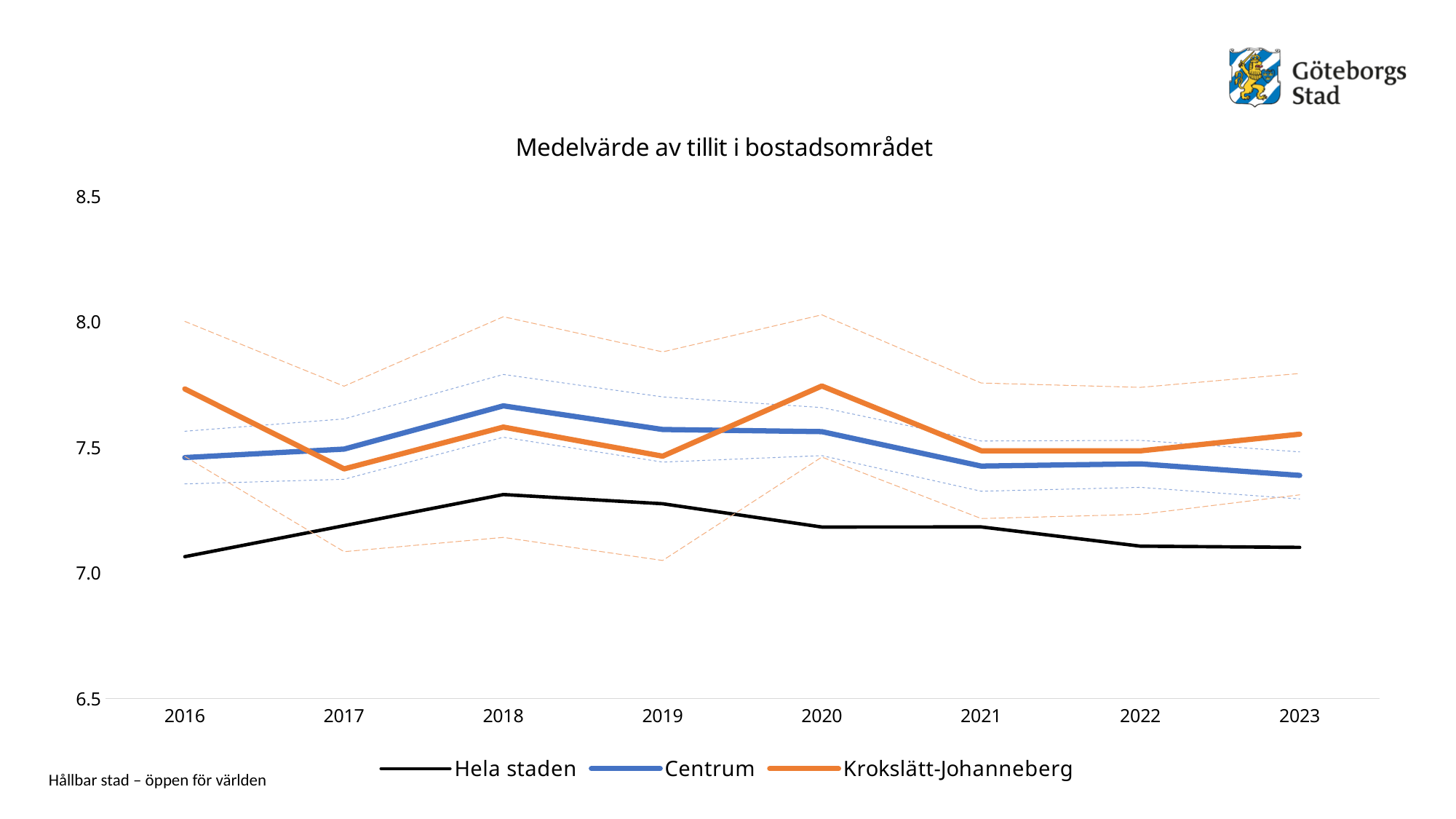
In 2017, which is higher: Centrum or Krokslätt-Johanneberg? Centrum Does the Hela staden line rise or fall from 2018 to 2023? Fall Is the value for Hela staden in 2016 greater or less than 7.0? greater What kind of chart is shown on the slide? Line chart How many series does the legend list? 3 Is the value for Krokslätt-Johanneberg in 2016 greater or less than 7.5? greater Is the value for Hela staden in 2018 greater or less than 7.5? less Which colour is used for the Centrum line? Blue How many years are shown on the x axis? 8 In which year does the Centrum line reach its highest value? 2018 What is the title of the chart? Medelvärde av tillit i bostadsområdet